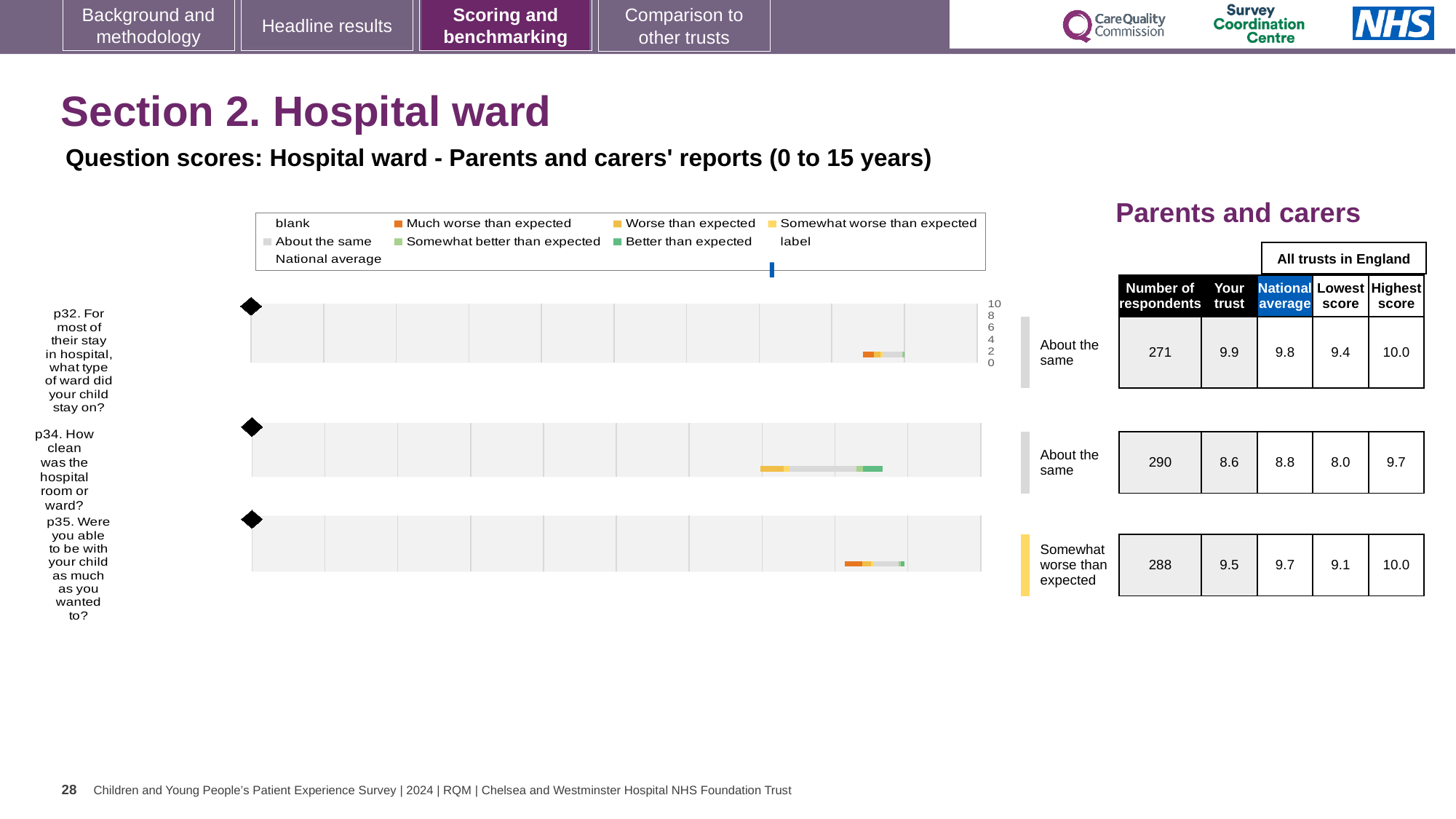
What benchmark category is shown for p35? Somewhat worse than expected For p34, what is the difference between the highest score and the lowest score across all trusts in England? 1.7 For p35, which is larger: the 'Your trust' score or the national average? National average What kind of chart is used to show the question scores on this slide? bar chart What is the national average score for p35 (Were you able to be with your child as much as you wanted to)? 9.7 What is the 'Your trust' score for p34 (How clean was the hospital room or ward?)? 8.6 For p32, how much higher is the 'Your trust' score than the national average? 0.1 Which question has the lowest 'Your trust' score? p34 How many respondents are recorded for p32 (what type of ward did your child stay on)? 271 Which question has the highest 'Your trust' score? p32 How many survey questions (p32, p34, p35) are plotted on the slide? 3 What colour is used in the legend for 'Much worse than expected'? Orange